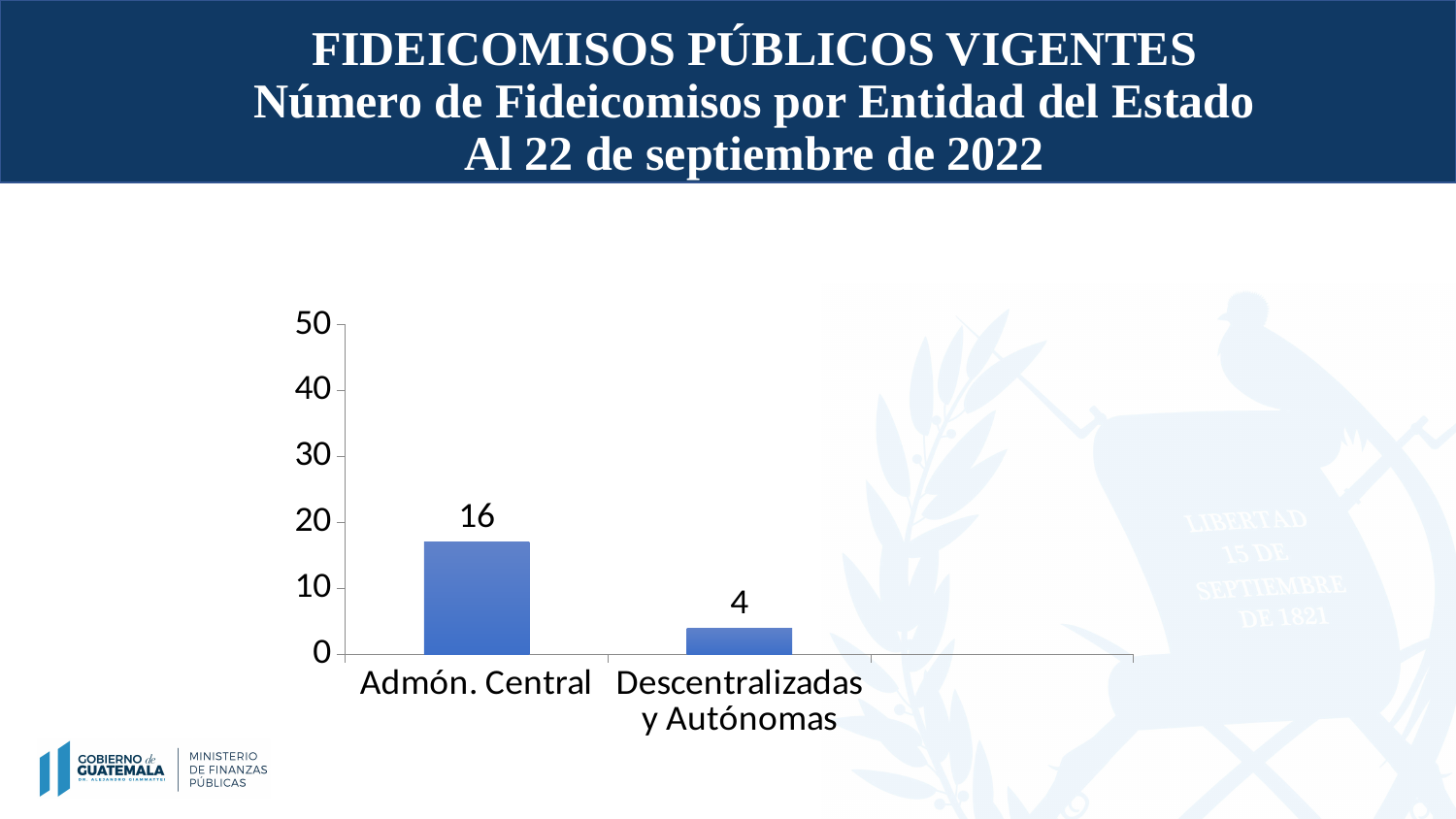
Which entity has the lowest number of fideicomisos? Descentralizadas y Autónomas Which is larger, the value for Admón. Central or for Descentralizadas y Autónomas? Admón. Central What kind of chart is shown on the slide? Bar chart What is the number of fideicomisos for Admón. Central? 16 What is the number of fideicomisos for Descentralizadas y Autónomas? 4 Is the value for Admón. Central greater or less than 20? less How many categories are shown on the x axis of the chart? 2 Which entity has the highest number of fideicomisos? Admón. Central What is the maximum value shown on the vertical axis of the chart? 50 What is the difference between the values for Admón. Central and Descentralizadas y Autónomas? 12 Is the value for Descentralizadas y Autónomas greater or less than 10? less What is the total number of fideicomisos across both entities shown? 20